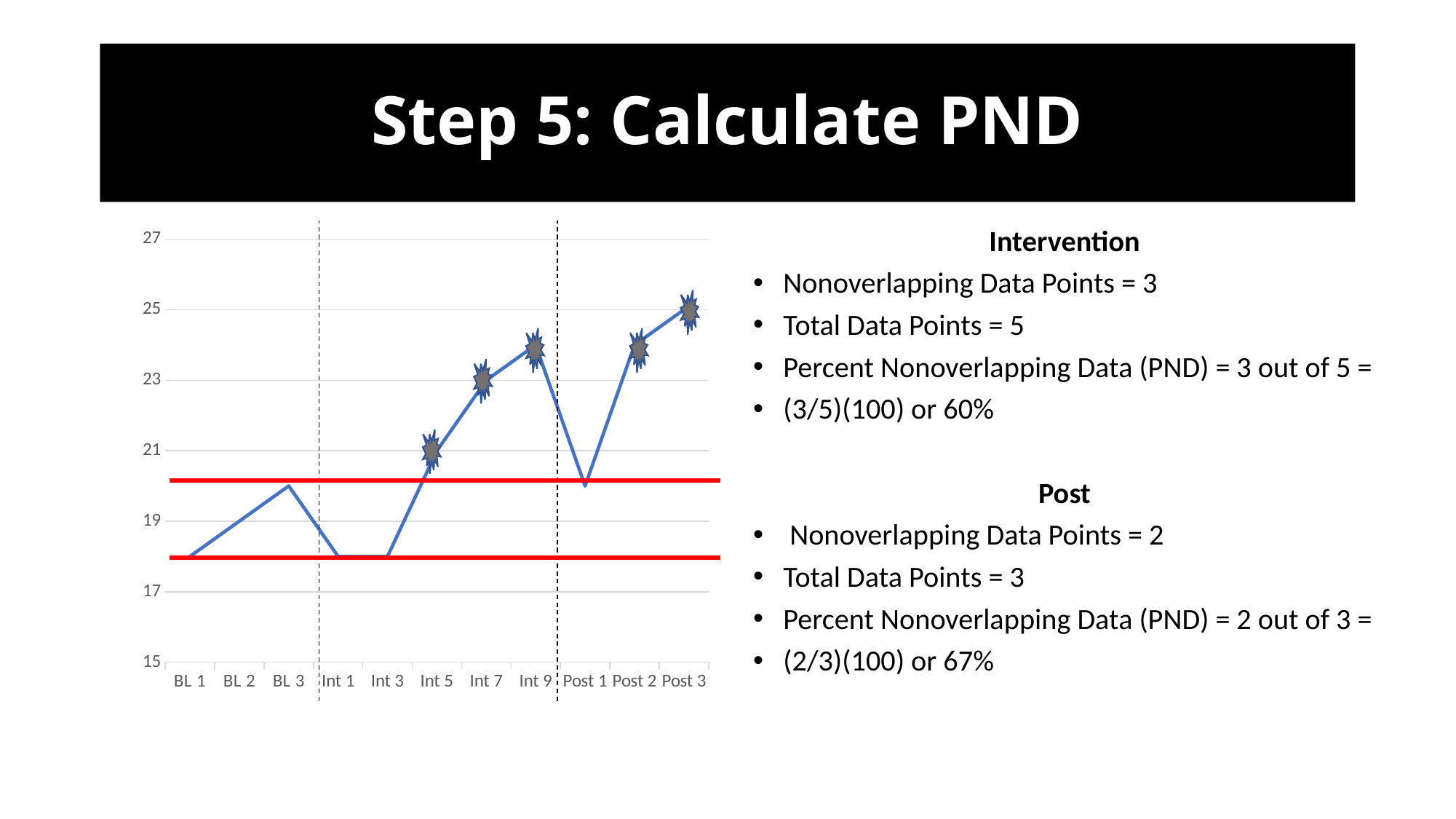
Is the value for BL 1 greater or less than 19? less What is the value at Int 7? 23 What is the value at Int 5? 21 How many red horizontal lines are drawn across the chart? 2 Which is larger, the value at Post 3 or the value at Int 7? Post 3 What is the value at Post 3? 25 Is the value for Int 9 greater or less than 23? greater What is the difference between the values at Int 7 and Int 5? 2 Which x-axis category has the highest value? Post 3 What type of chart is shown on the slide? line chart Do the values rise or fall from Int 1 to Int 9? rise How many data points are plotted on the chart? 11